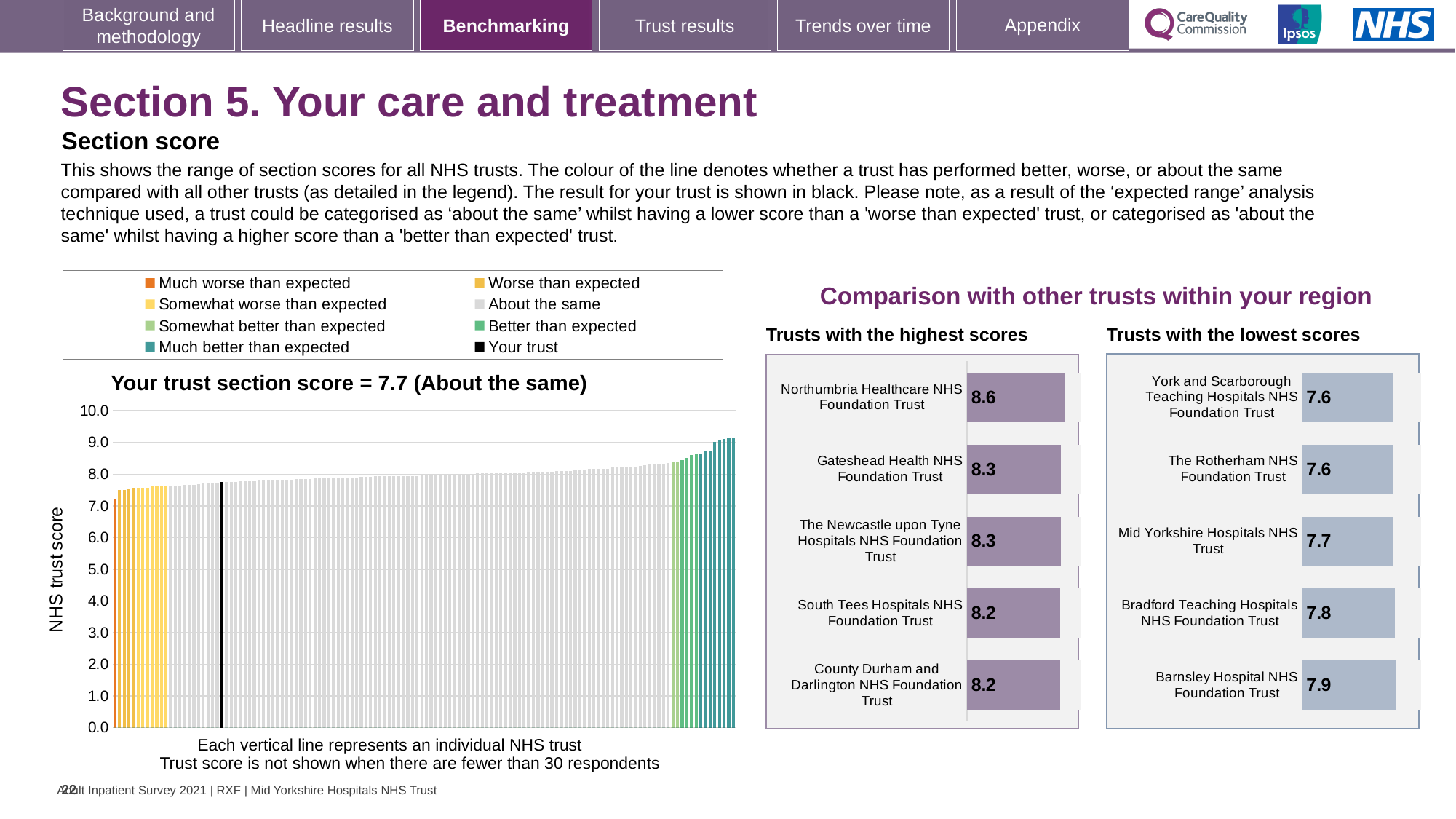
In the 'Your trust section score' chart, what colour represents 'Your trust' in the legend? black In the 'Trusts with the highest scores' chart, which trust has the highest score? Northumbria Healthcare NHS Foundation Trust What kind of chart is the 'Your trust section score' chart? bar chart In the 'Your trust section score' chart, how many entries does the legend list? 8 In the 'Trusts with the lowest scores' chart, what is the score for Barnsley Hospital NHS Foundation Trust? 7.9 In the 'Your trust section score' chart, what is the section score for your trust? 7.7 In the 'Trusts with the highest scores' chart, how many trusts are shown? 5 In the 'Your trust section score' chart, do the trust scores rise or fall from left to right along the x axis? rise In the 'Trusts with the lowest scores' chart, which has the larger score: Bradford Teaching Hospitals NHS Foundation Trust or Mid Yorkshire Hospitals NHS Trust? Bradford Teaching Hospitals NHS Foundation Trust In the 'Trusts with the lowest scores' chart, which trust has the highest score? Barnsley Hospital NHS Foundation Trust In the 'Trusts with the highest scores' chart, what is the score for Northumbria Healthcare NHS Foundation Trust? 8.6 In the 'Trusts with the highest scores' chart, what is the difference between the scores of Northumbria Healthcare NHS Foundation Trust and Gateshead Health NHS Foundation Trust? 0.3